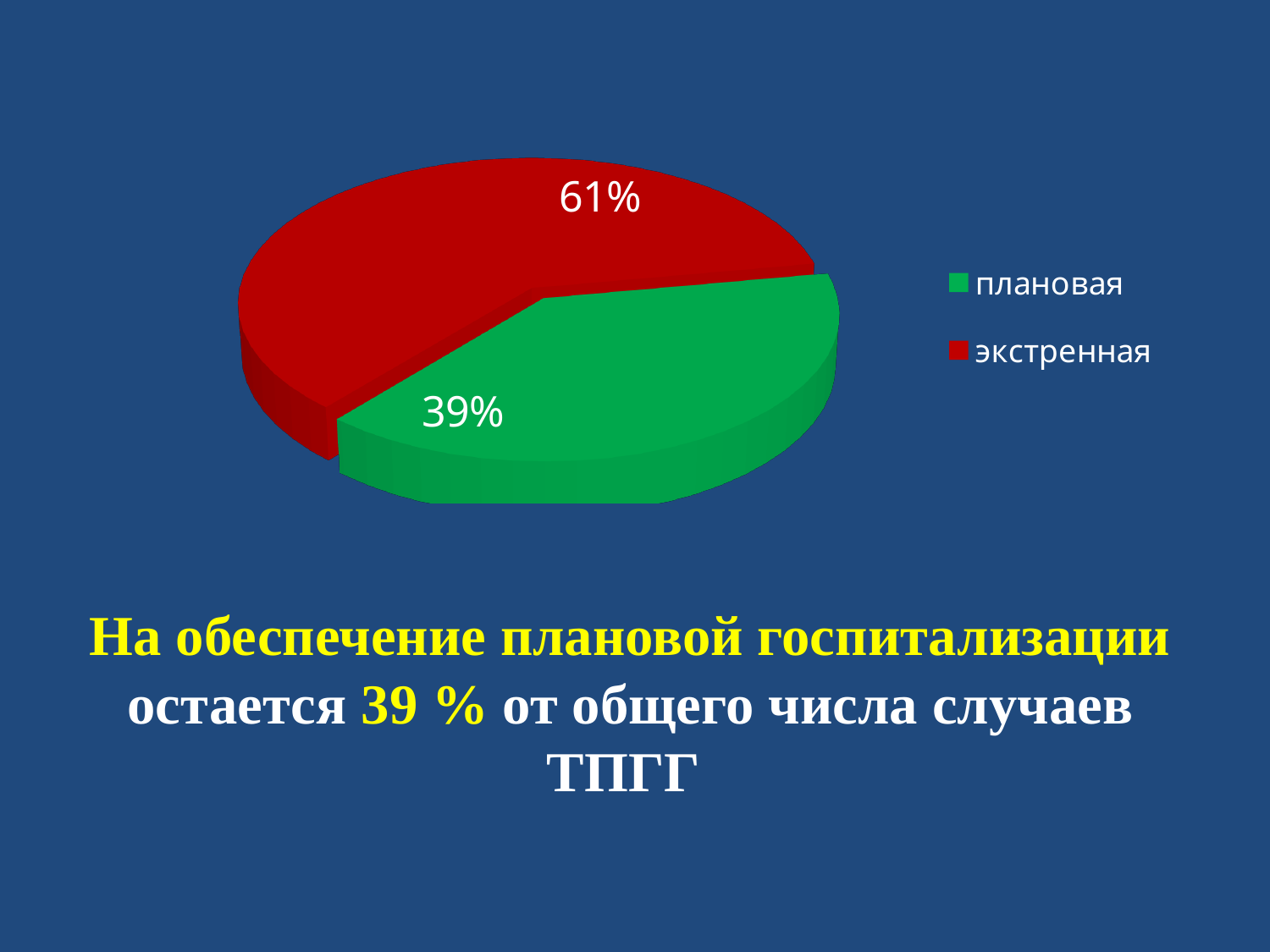
Which category has the largest slice of the pie? экстренная How many entries does the legend list? 2 What share of the pie does the экстренная slice represent? 61% What colour is the экстренная slice? red What share of the pie does the плановая slice represent? 39% Which category has the smallest slice of the pie? плановая What colour is the плановая slice? green How many slices does the pie chart have? 2 What is the difference in percentage points between the экстренная and плановая slices? 22 What kind of chart is shown on the slide? pie chart Which is larger, the плановая slice or the экстренная slice? экстренная